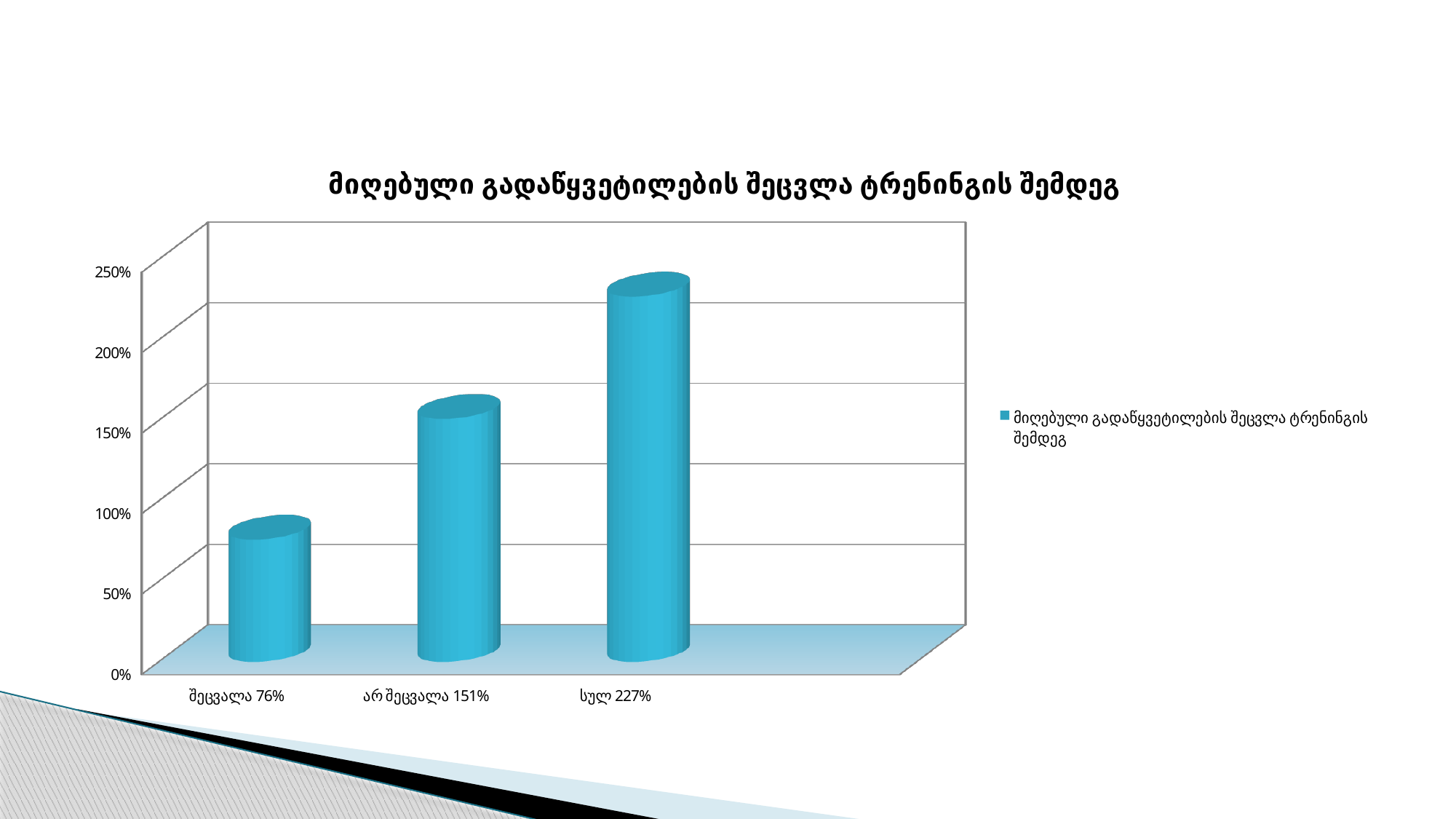
What is the difference between the values for "სულ" and "შეცვალა"? 151% What value is shown for the category "სულ"? 227% Is the value for "შეცვალა" greater or less than 100%? less How many bars are plotted in the chart? 3 Which is larger, the value for "არ შეცვალა" or the value for "შეცვალა"? არ შეცვალა Which category has the highest bar? სულ 227% Is the value for "სულ" greater or less than 200%? greater What kind of chart is shown on the slide? bar chart How many series does the legend list? 1 What value is shown for the category "არ შეცვალა"? 151% Which category has the lowest bar? შეცვალა 76% What value is shown for the category "შეცვალა"? 76%